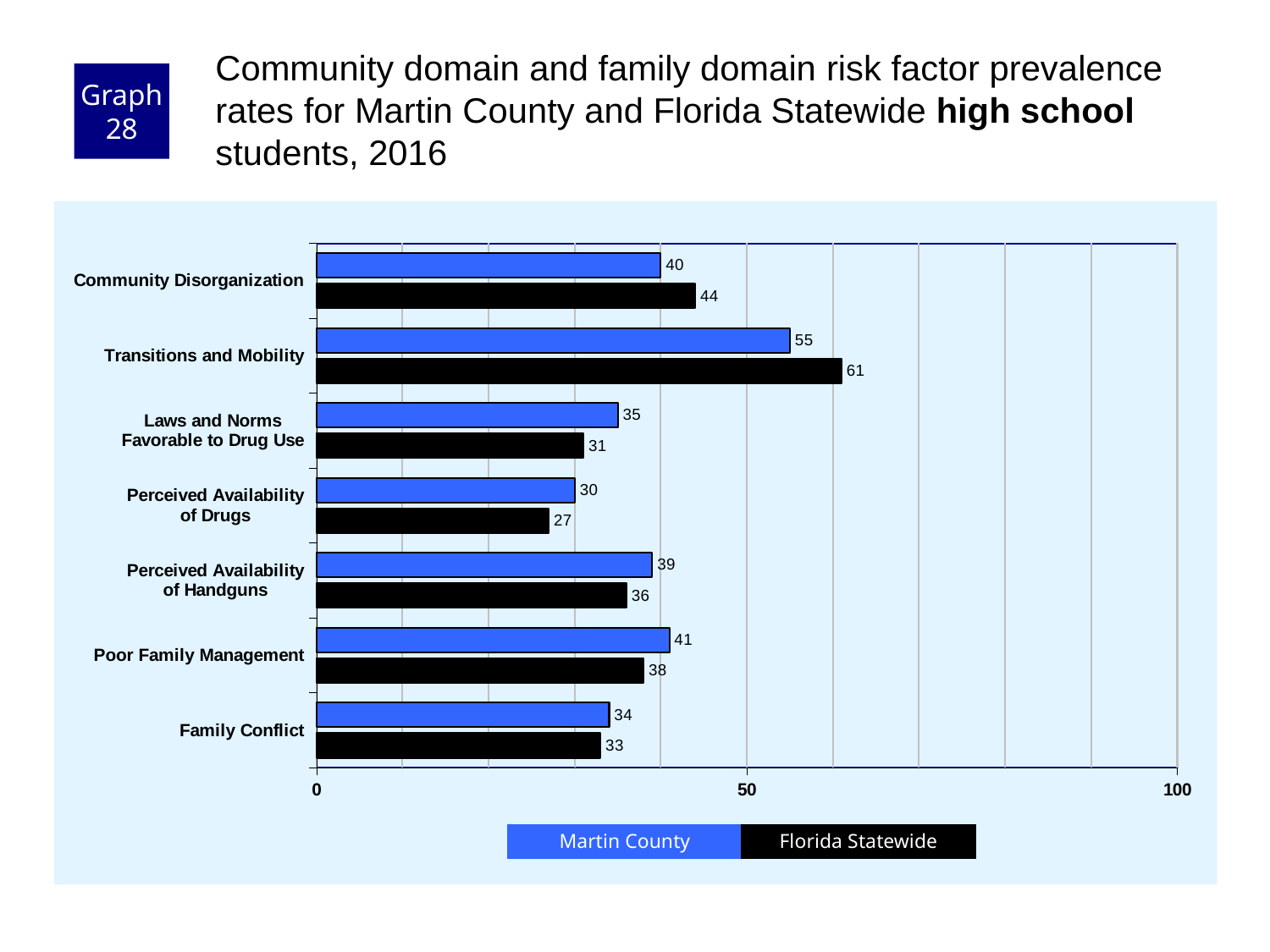
What is the Martin County value for Transitions and Mobility? 55 What is the Florida Statewide value for Community Disorganization? 44 Is the Florida Statewide value for Transitions and Mobility greater or less than 50? greater Which risk factor has the lowest Martin County value? Perceived Availability of Drugs What is the Florida Statewide value for Perceived Availability of Drugs? 27 What kind of chart is shown on the slide? bar chart Which risk factor has the highest Florida Statewide value? Transitions and Mobility How many series does the legend list? 2 For Poor Family Management, which is larger: the Martin County value or the Florida Statewide value? Martin County What is the difference between the Martin County and Florida Statewide values for Laws and Norms Favorable to Drug Use? 4 What is the difference between the Florida Statewide and Martin County values for Transitions and Mobility? 6 How many risk factor categories are shown on the chart? 7